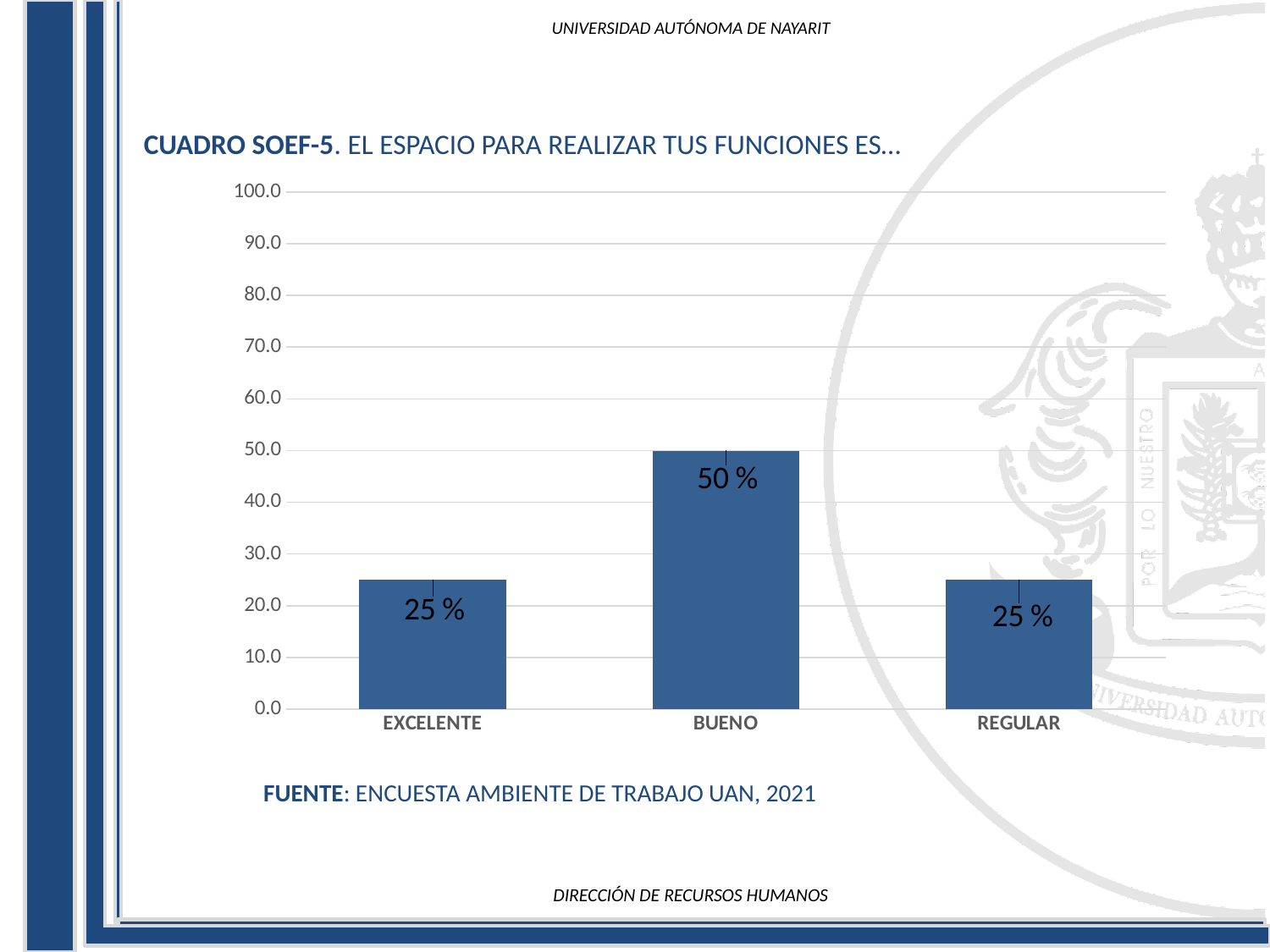
What kind of chart is shown on the slide? bar chart How many categories are shown on the x axis? 3 What is the value for REGULAR? 25 % Which is larger, the value for BUENO or the value for REGULAR? BUENO Is the value for BUENO greater or less than 40? greater Which category has the highest value? BUENO What is the value for BUENO? 50 % What is the source cited below the chart? ENCUESTA AMBIENTE DE TRABAJO UAN, 2021 What is the title of the chart? CUADRO SOEF-5. EL ESPACIO PARA REALIZAR TUS FUNCIONES ES… What is the difference between the values for BUENO and EXCELENTE? 25 % What is the value for EXCELENTE? 25 % Is the value for REGULAR greater or less than 30? less